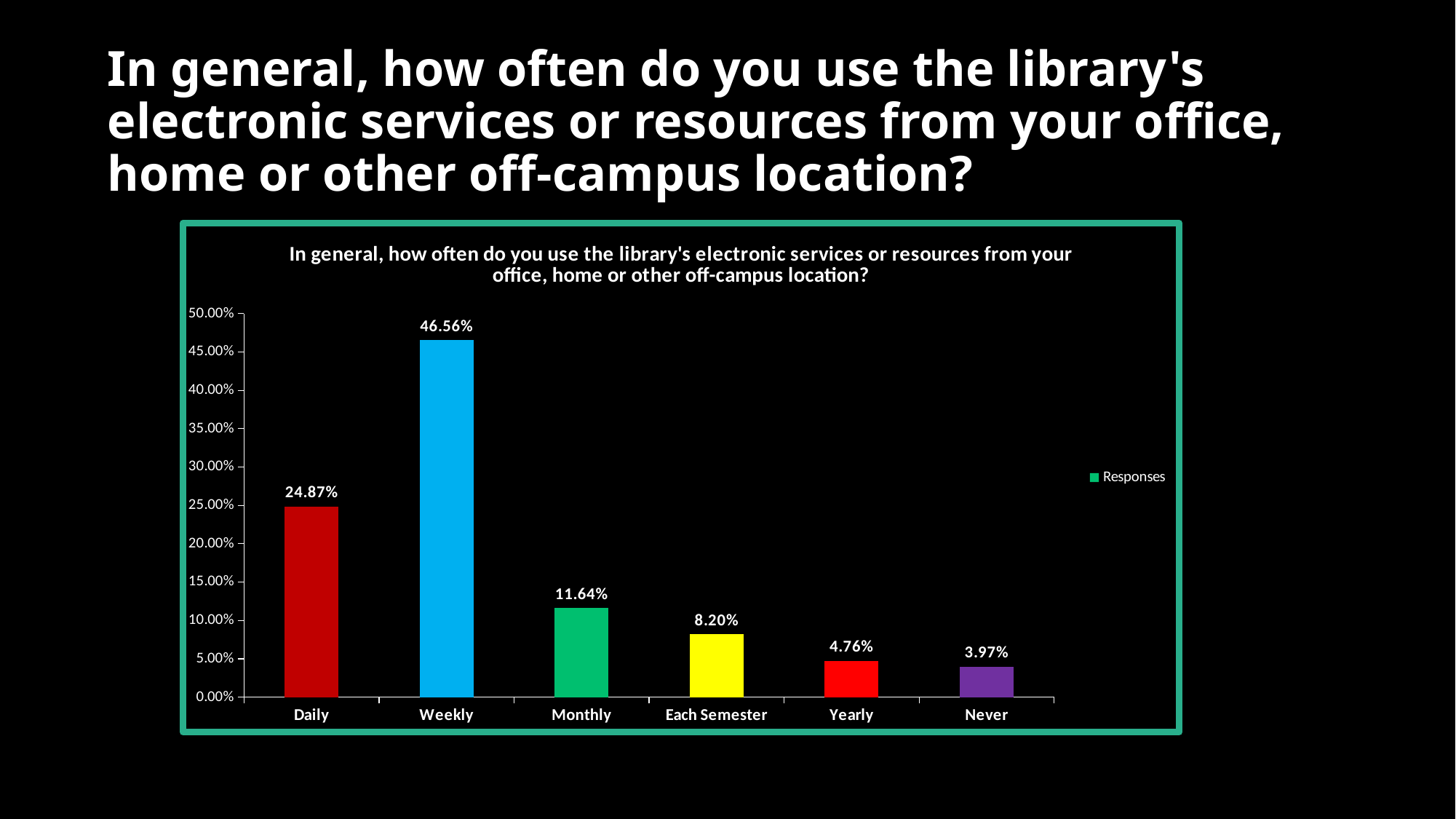
Which is larger, the value for Daily or the value for Monthly? Daily What kind of chart is shown on the slide? Bar chart What series name does the legend list? Responses What is the difference between the Monthly and Yearly values? 6.88% Which category has the lowest value? Never Is the value for Daily greater or less than 20.00%? greater What is the difference between the Weekly and Daily values? 21.69% What percentage of responses is shown for Weekly? 46.56% What is the value for Never? 3.97% How many categories are shown on the x axis? 6 Which category has the highest value? Weekly What is the value for Each Semester? 8.20%